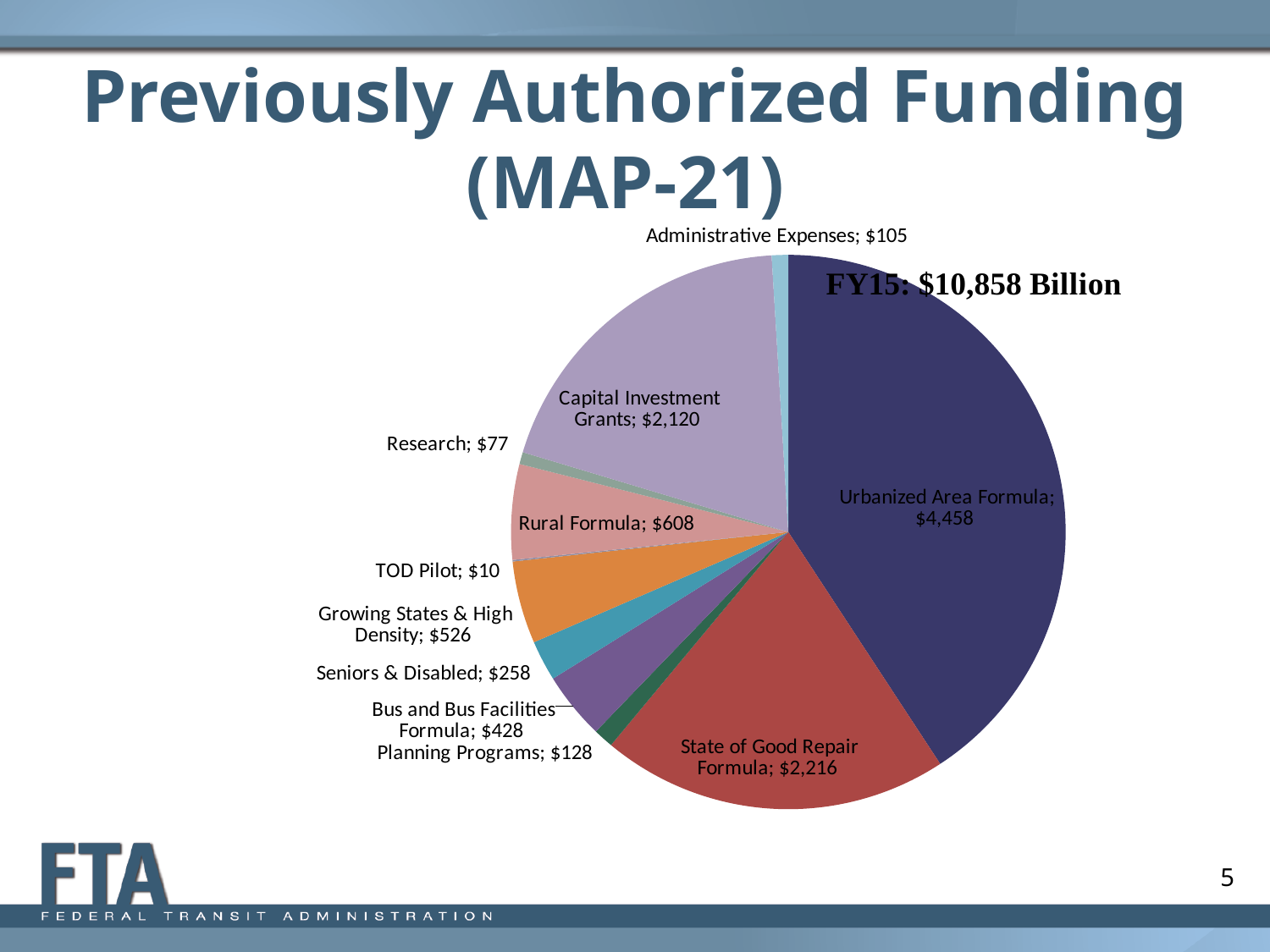
What kind of chart is shown on the slide? pie chart What is the value for Urbanized Area Formula? $4,458 Which category has the largest slice of the pie? Urbanized Area Formula Which is larger, Rural Formula or Growing States & High Density? Rural Formula What is the value for State of Good Repair Formula? $2,216 Which category has the smallest slice of the pie? TOD Pilot What is the difference between the Urbanized Area Formula value and the State of Good Repair Formula value? $2,242 What FY15 total is stated next to the pie chart? $10,858 Billion What is the value for Bus and Bus Facilities Formula? $428 How many categories are shown in the pie chart? 11 What is the value for Capital Investment Grants? $2,120 What is the value for TOD Pilot? $10